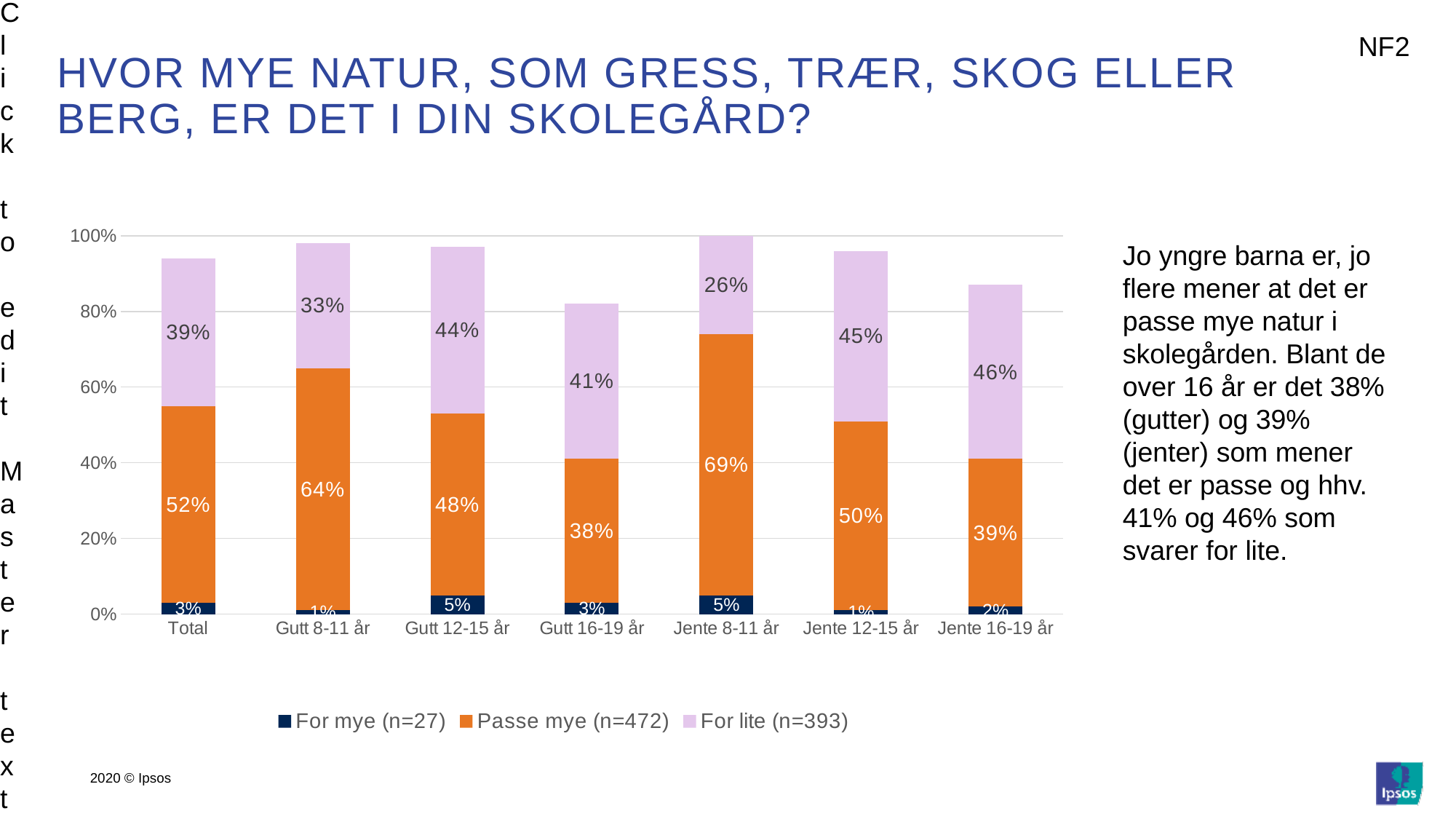
What percentage of Gutt 8-11 år answered Passe mye? 64% Which category has the highest Passe mye value? Jente 8-11 år How many series does the legend list? 3 What is the For mye value for the Total category? 3% What is the sample size (n) shown in the legend for Passe mye? 472 How many categories are shown on the x axis? 7 What is the difference in percentage points between the Passe mye values for Gutt 8-11 år and Gutt 16-19 år? 26 percentage points What is the For lite value for Jente 12-15 år? 45% Which category has the lowest For lite value? Jente 8-11 år Which is larger for Gutt 12-15 år: the Passe mye value or the For lite value? Passe mye What is the total of the stacked bar for Gutt 16-19 år? 82% What kind of chart is shown on the slide? Stacked bar chart